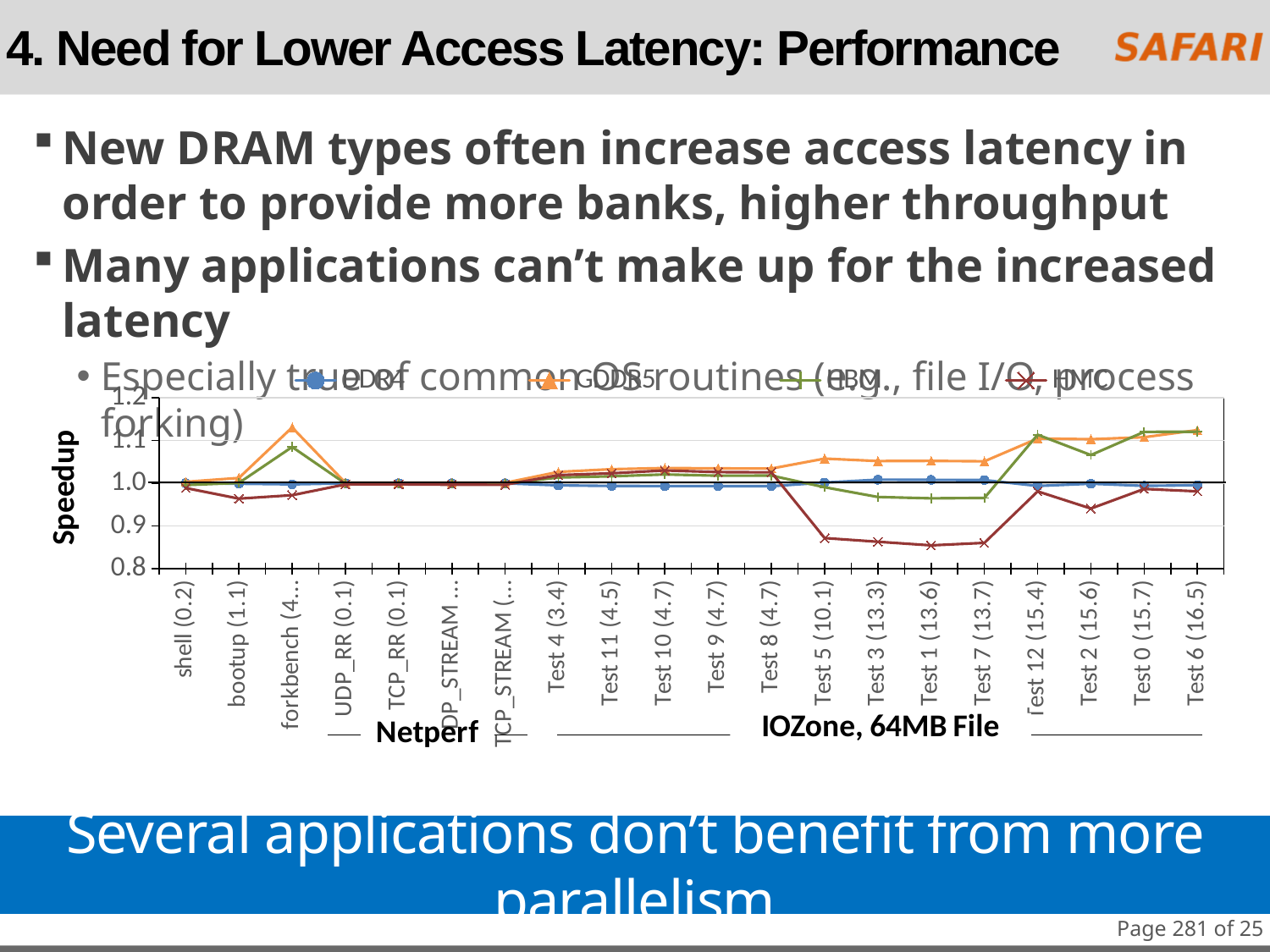
Which two benchmark groups are labelled beneath the x axis of the chart? Netperf and IOZone, 64MB File What kind of chart is shown on the slide? line chart How many categories are plotted along the x axis of the chart? 20 Is the GDDR5 speedup for forkbench greater or less than 1.1? greater How many series does the chart's legend list? 4 Is the HBM speedup for Test 6 (16.5) greater or less than 1.1? greater What is the label of the y axis of the chart? Speedup For forkbench, which series has the higher speedup, GDDR5 or HBM? GDDR5 Is the HBM speedup for Test 3 (13.3) greater or less than 1.0? less